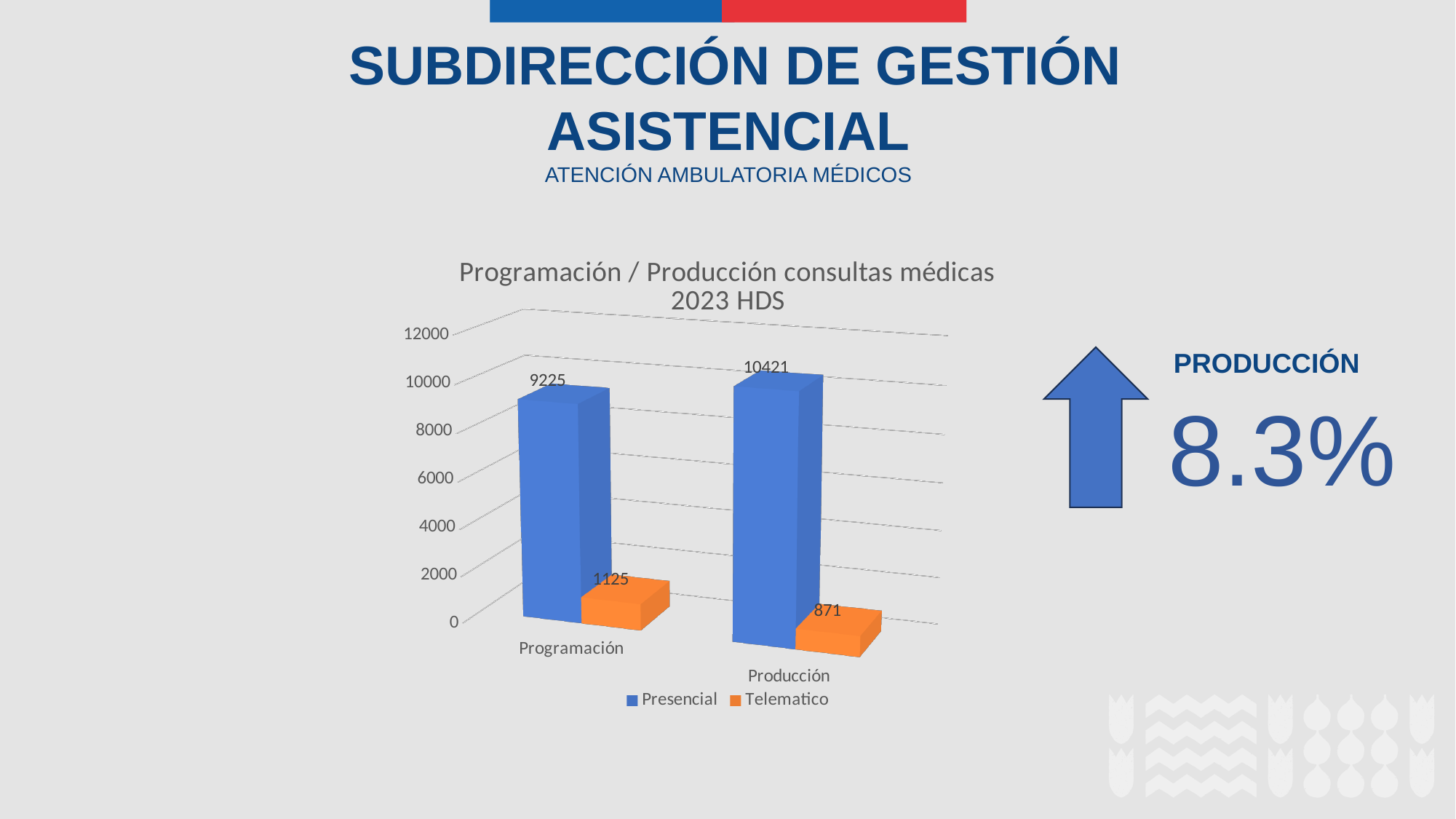
What is the Telematico value for Producción? 871 What kind of chart is shown? bar chart What is the Presencial value for Producción? 10421 Which category has the lower Telematico value? Producción Is the Presencial value for Producción greater or less than 10000? greater What is the title of the chart? Programación / Producción consultas médicas 2023 HDS How many series does the legend list? 2 What is the Telematico value for Programación? 1125 What is the Presencial value for Programación? 9225 What is the difference between the Telematico values for Programación and Producción? 254 What is the difference between the Presencial values for Producción and Programación? 1196 Which category has the higher Presencial value? Producción